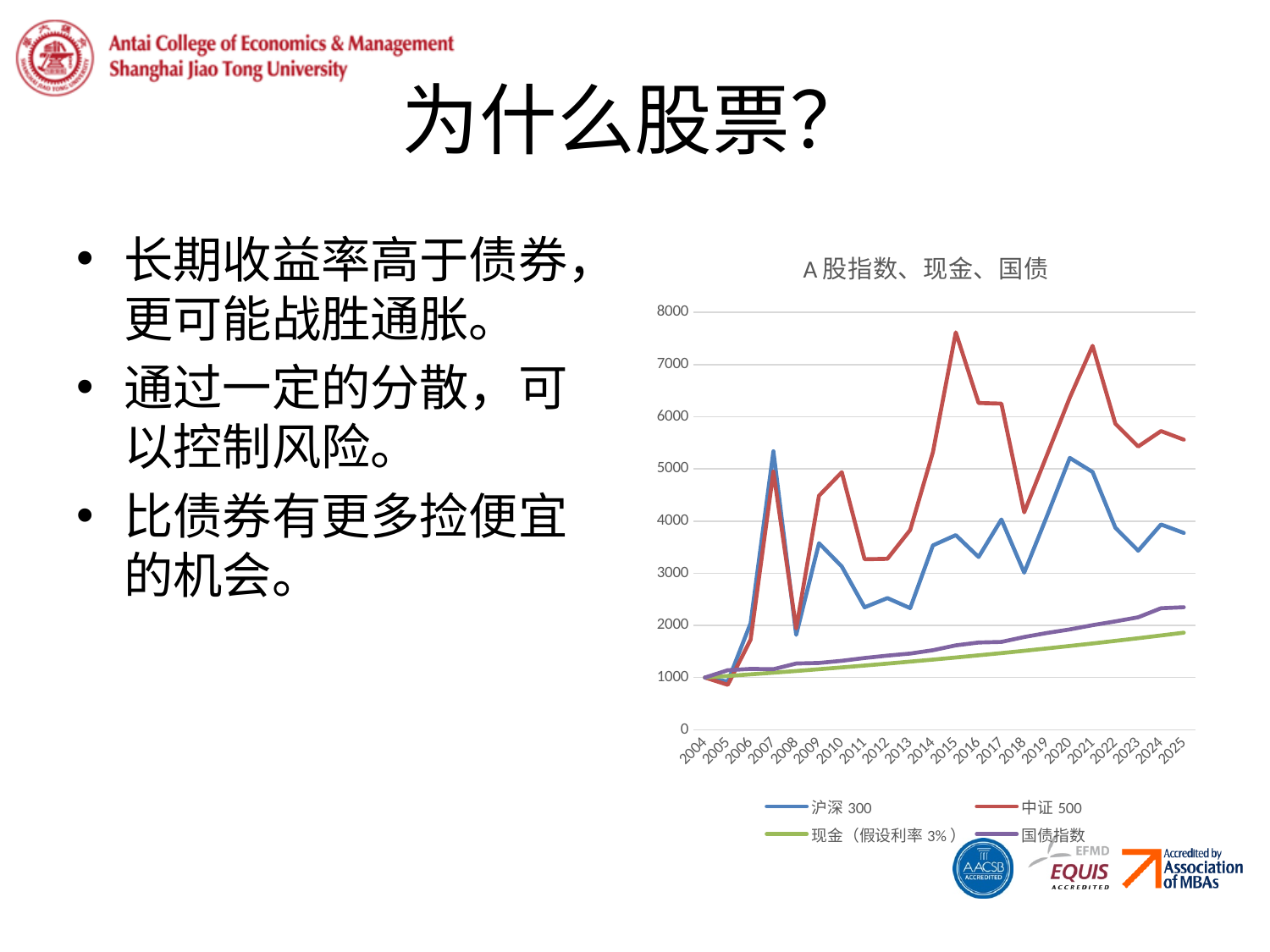
How many series does the chart's legend list? 4 What is the title of the chart? A 股指数、现金、国债 Which is larger in 2020, the value for 沪深 300 or the value for 中证 500? 中证 500 In which year does the 中证 500 series reach its highest value? 2015 Does the 现金（假设利率 3%） series rise or fall from 2004 to 2025? rise Which series has the highest value in 2025? 中证 500 Which series has the lowest value in 2025? 现金（假设利率 3%） Is the value for 国债指数 in 2025 greater or less than 2000? greater What kind of chart is shown on the slide? line chart How many years are shown along the x axis of the chart? 22 Is the value for 沪深 300 in 2015 greater or less than 4000? less Is the value for 中证 500 in 2015 greater or less than 7000? greater